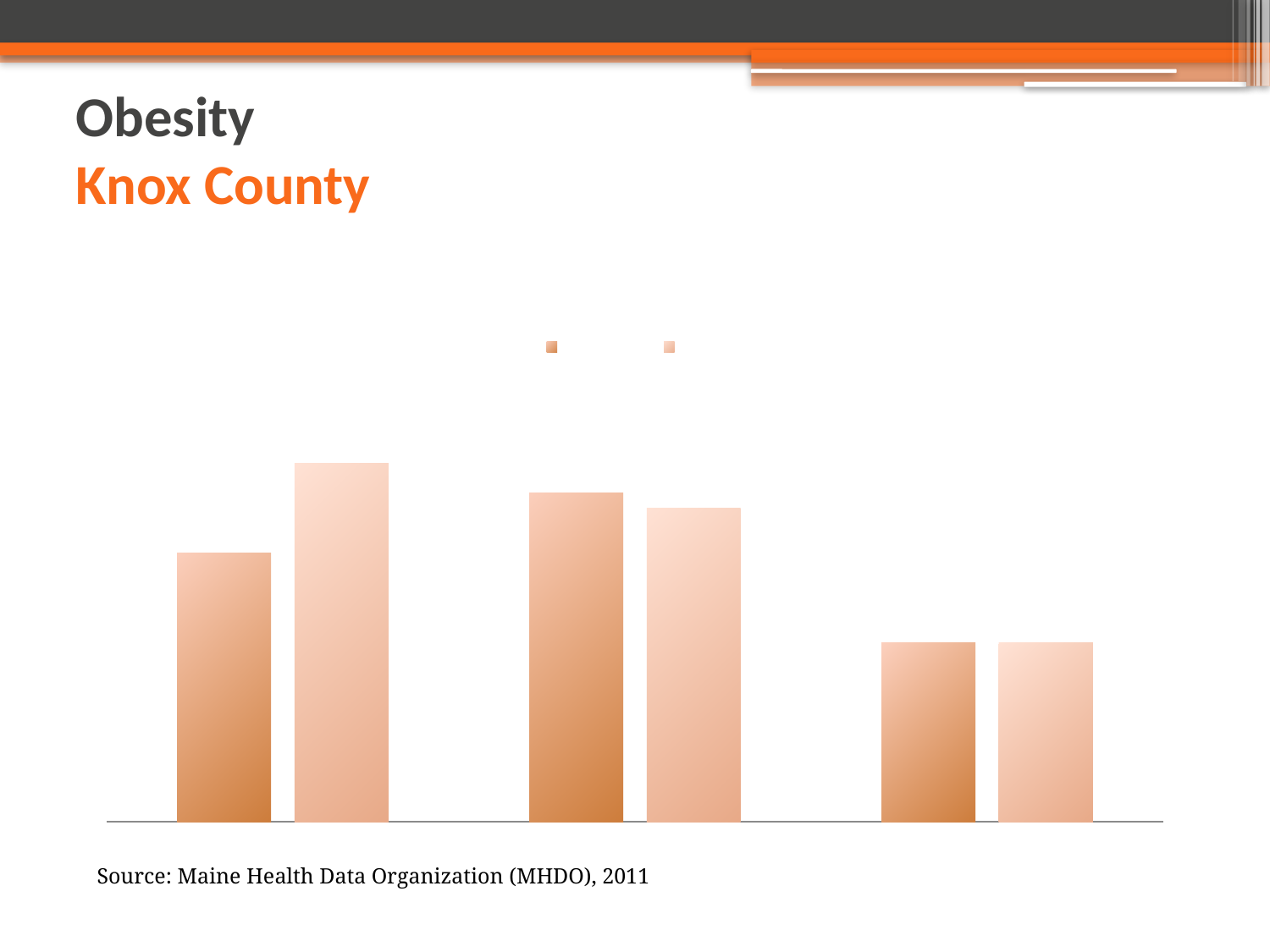
Do the lighter-coloured bars rise or fall from left to right across the chart? fall How many bars are plotted in the chart? 6 What is the title of the slide containing the chart? Obesity Knox County How many series does the legend indicate? 2 Which group of bars has the shortest bars in the chart? the rightmost group In the middle group of bars, is the darker bar or the lighter bar taller? the darker bar In the leftmost group of bars, is the lighter bar or the darker bar taller? the lighter bar What kind of chart is shown on the slide? bar chart How many groups of bars does the chart show? 3 What source is cited below the chart? Maine Health Data Organization (MHDO), 2011 Which group of bars contains the tallest bar in the chart? the leftmost group